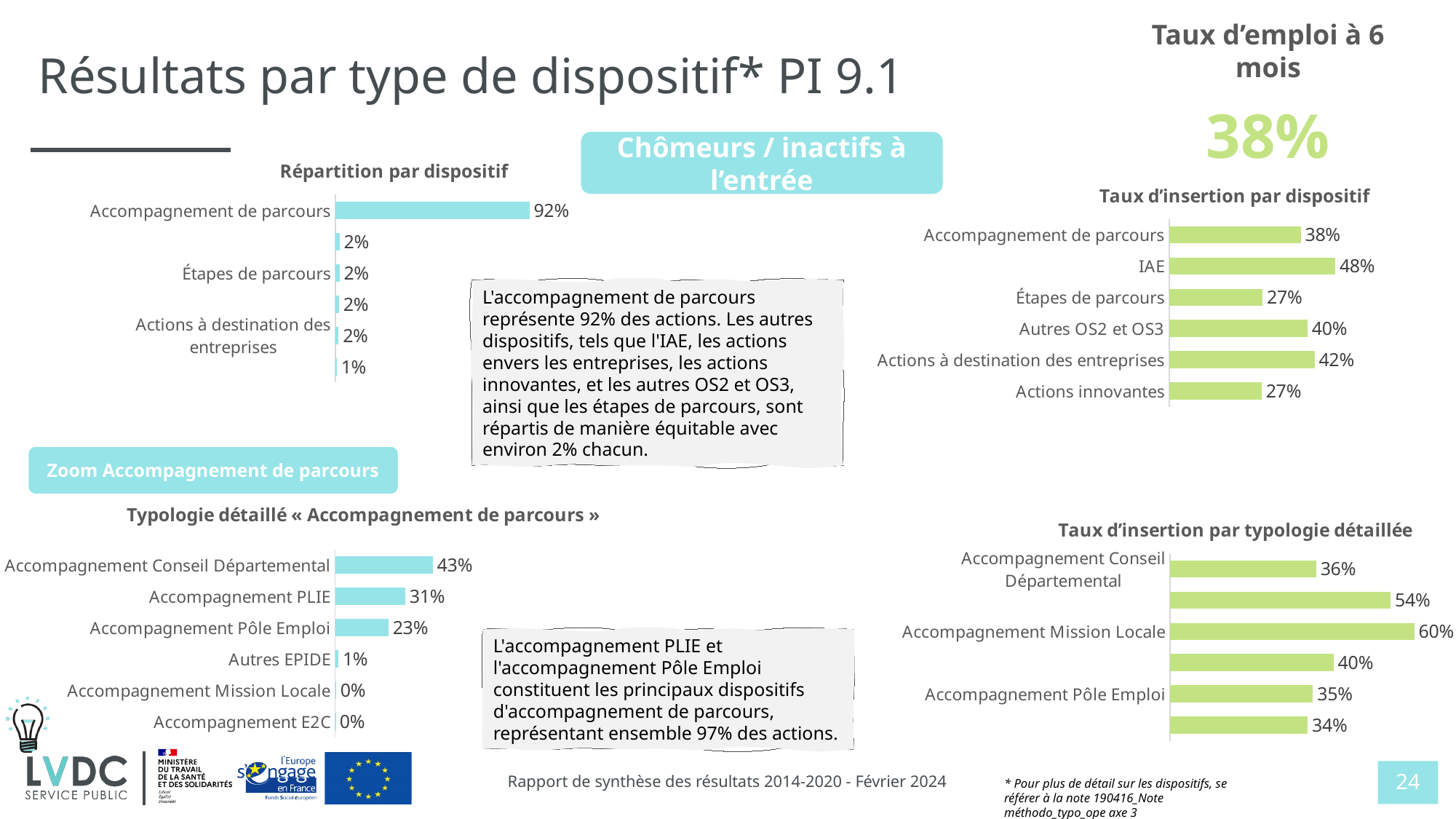
In the 'Typologie détaillé « Accompagnement de parcours »' chart, what is the value for Accompagnement PLIE? 31% In the 'Taux d'insertion par dispositif' chart, how many categories are shown? 6 In the 'Typologie détaillé « Accompagnement de parcours »' chart, which category has the highest value? Accompagnement Conseil Départemental In the 'Taux d'insertion par dispositif' chart, what is the value for IAE? 48% In the 'Répartition par dispositif' chart, what is the value for Accompagnement de parcours? 92% In the 'Répartition par dispositif' chart, what is the value for Étapes de parcours? 2% In the 'Taux d'insertion par typologie détaillée' chart, what is the difference between Accompagnement Conseil Départemental and Accompagnement Pôle Emploi? 1% In the 'Taux d'insertion par dispositif' chart, which category has the highest value? IAE What type of chart is 'Taux d'insertion par dispositif'? Bar chart In the 'Taux d'insertion par typologie détaillée' chart, what is the value for Accompagnement Mission Locale? 60% In the 'Typologie détaillé « Accompagnement de parcours »' chart, which is larger: Accompagnement PLIE or Accompagnement Pôle Emploi? Accompagnement PLIE In the 'Taux d'insertion par dispositif' chart, what is the difference between Actions à destination des entreprises and Étapes de parcours? 15%